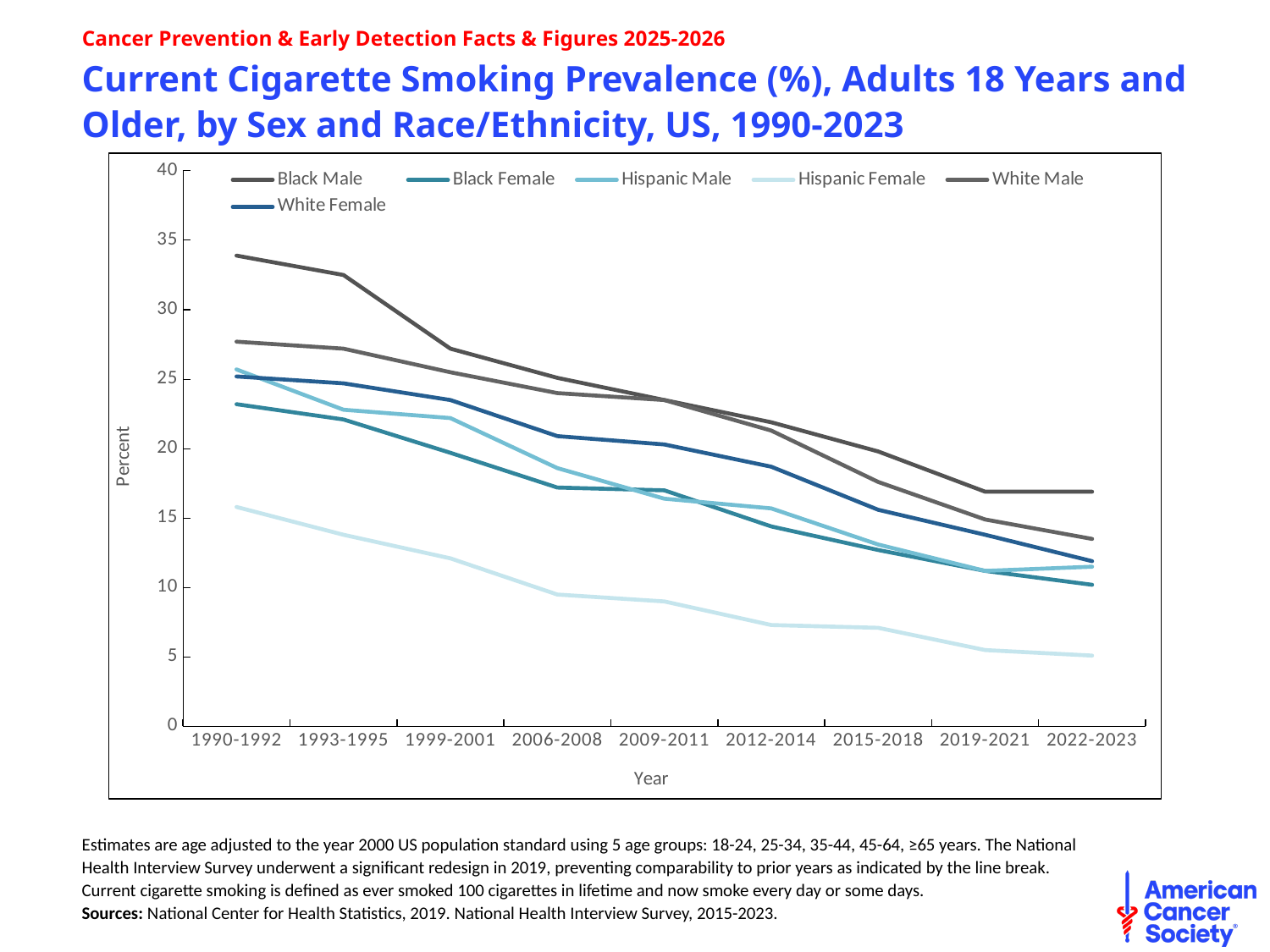
Does the Hispanic Female line rise or fall from 1990-1992 to 2022-2023? fall Is the value for Black Female in 1990-1992 greater or less than 20? greater What is the label on the y axis? Percent Which series has the lowest value in 2022-2023? Hispanic Female What is the label on the x axis? Year How many year periods are shown along the x axis? 9 In 1990-1992, which is larger: the value for Black Female or the value for Hispanic Female? Black Female Is the value for Hispanic Female in 1990-1992 greater or less than 20? less How many series does the legend list? 6 Is the value for Black Female in 2022-2023 greater or less than 15? less What kind of chart is shown on the slide? line chart